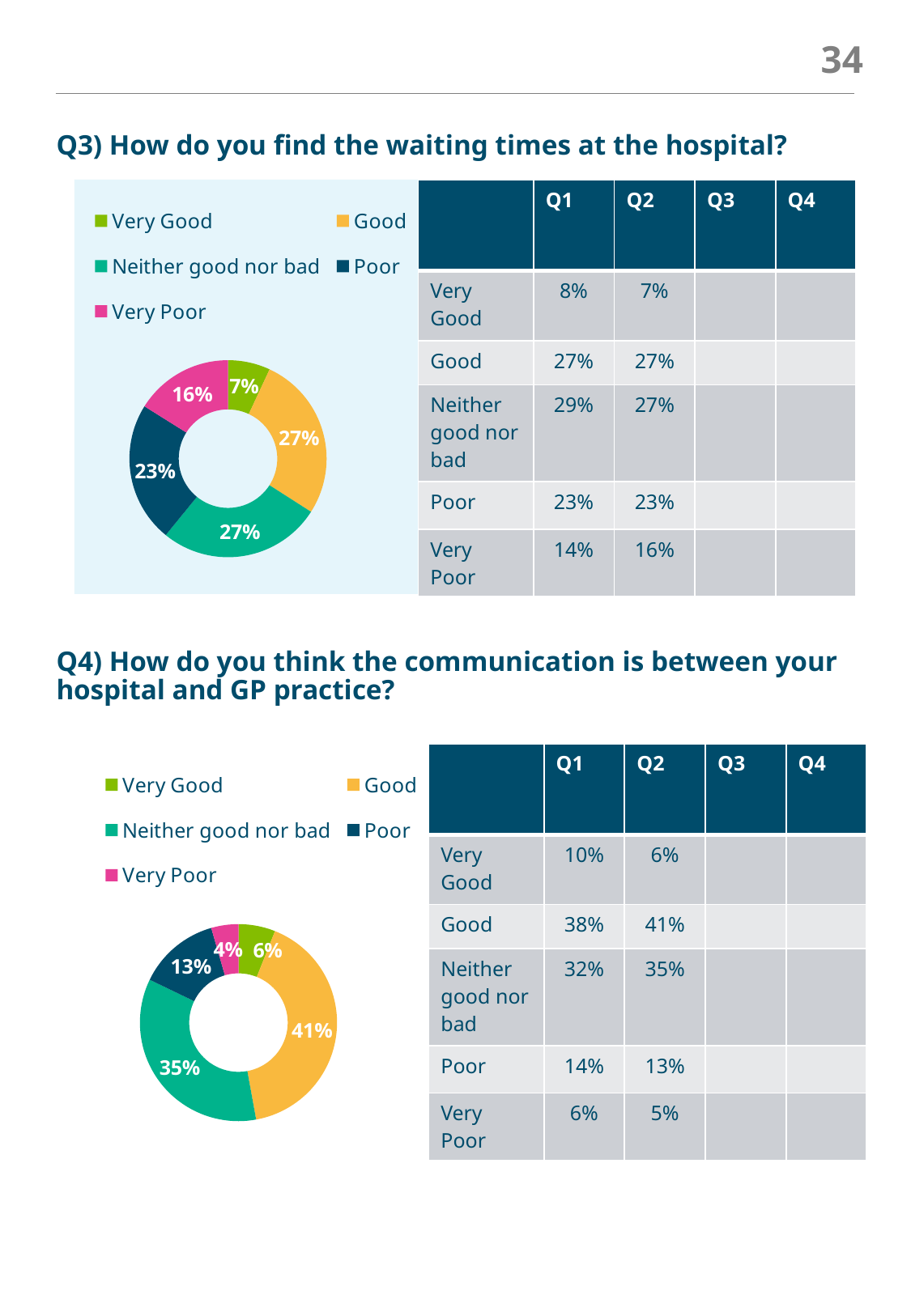
In the Q3 waiting times chart, which is larger: Poor or Very Good? Poor In the Q3 waiting times chart, what is the difference between the Poor and Very Poor shares? 7% In the Q3 waiting times chart, what percentage is shown for Very Poor? 16% What type of chart is used for the Q3 waiting times question? Donut chart How many categories does the legend of the Q4 communication chart list? 5 In the Q4 communication chart, what percentage is shown for Neither good nor bad? 35% In the Q4 communication chart, what is the difference between the Good and Neither good nor bad shares? 6% In the Q3 waiting times chart, what percentage is shown for Poor? 23% In the Q4 communication chart, which category has the smallest share? Very Poor In the Q3 waiting times chart, which category has the smallest share? Very Good In the Q4 communication chart, what percentage is shown for Good? 41% In the Q4 communication chart, which category has the largest share? Good